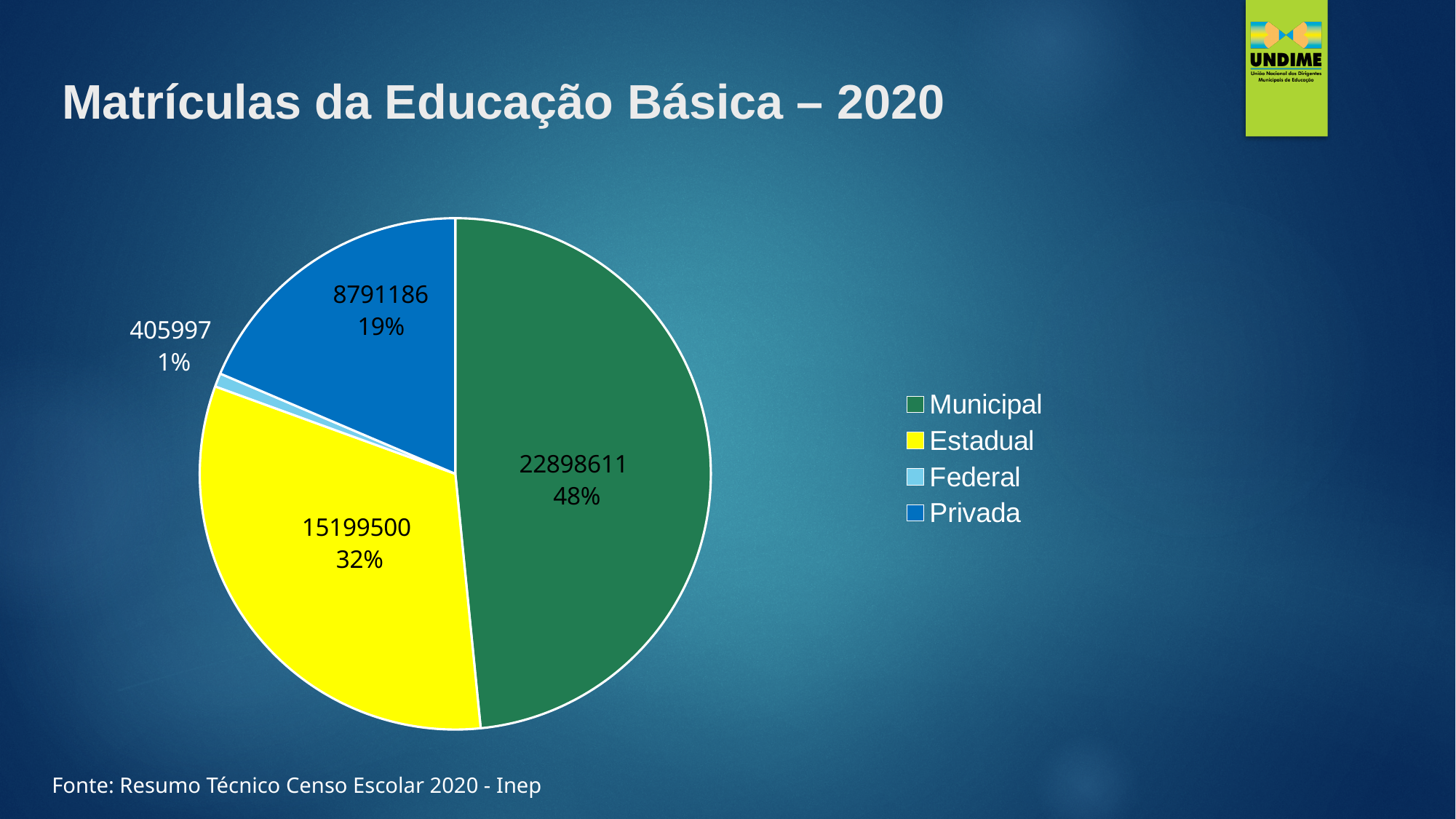
Which category has the smallest slice? Federal What share of the pie does Privada represent? 19% What is the value for Estadual? 15199500 What is the difference between the Municipal and Estadual values? 7699111 Which is larger, Estadual or Privada? Estadual What share of the pie does Estadual represent? 32% What is the value for Privada? 8791186 Which category has the largest slice? Municipal What type of chart is shown on the slide? pie chart What is the value for Federal? 405997 What is the value for Municipal? 22898611 How many categories does the legend list? 4